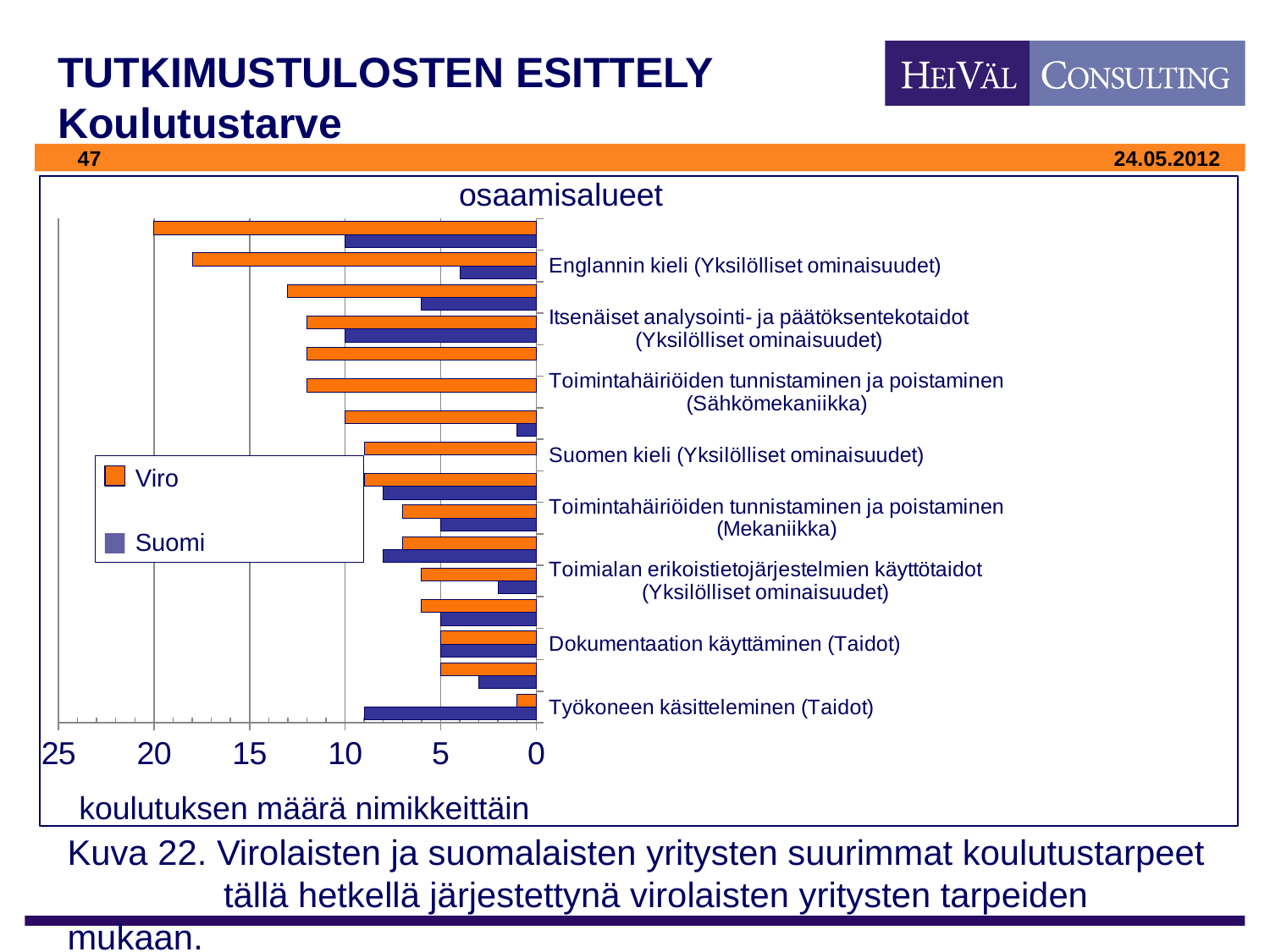
What is the title of the chart? osaamisalueet What are the two series named in the chart legend? Viro and Suomi What is the largest value shown on the chart's value axis? 25 Is the longest Suomi bar in the chart greater or less than 15? less What kind of chart is shown on the slide? bar chart How many series does the legend of the chart list? 2 Is the longest Viro bar in the chart greater or less than 15? greater Which series, Viro or Suomi, has the longest bar in the chart? Viro